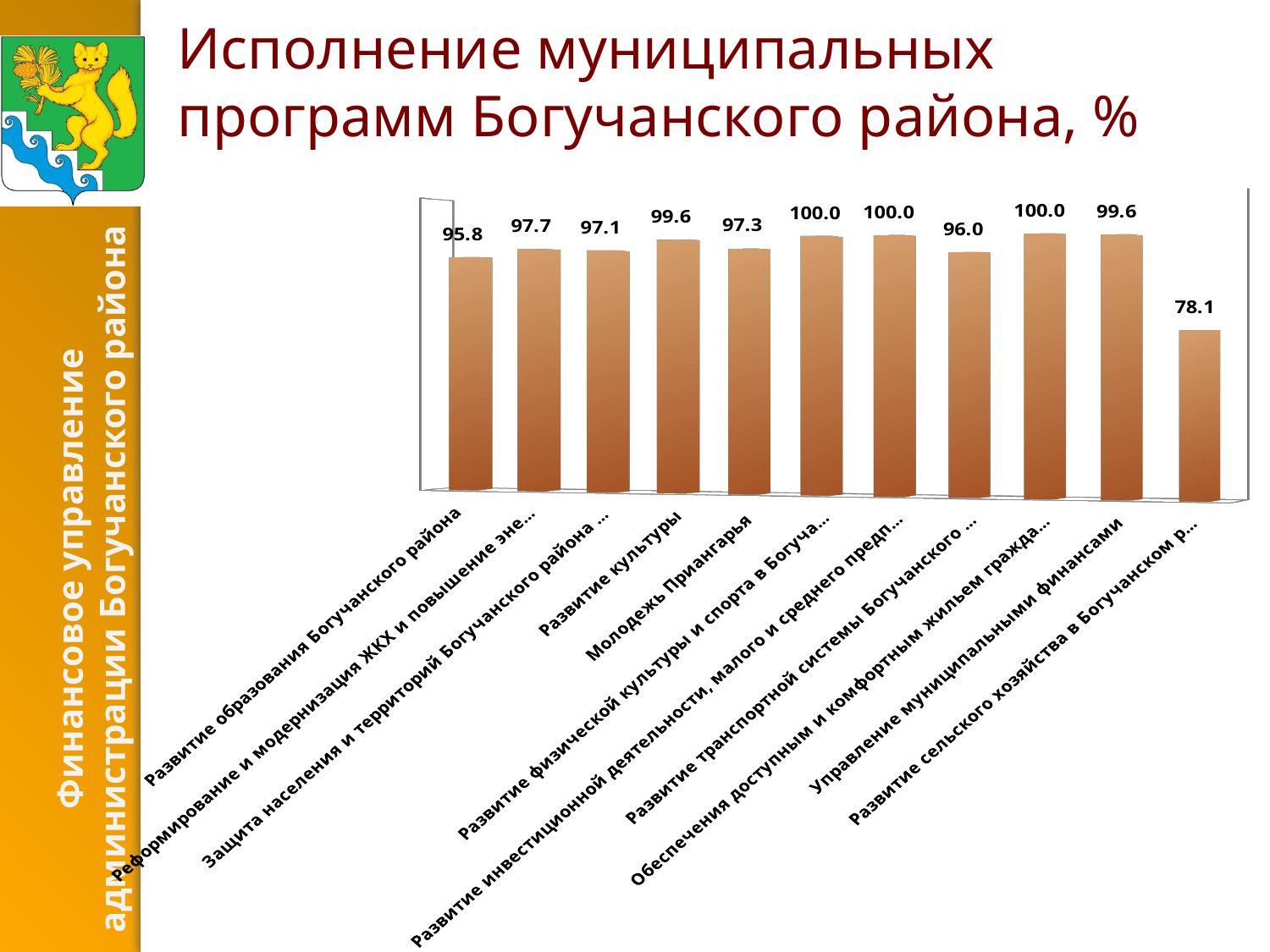
What is the value for Молодежь Приангарья? 97.3 What is the difference between the values for Развитие культуры and Молодежь Приангарья? 2.3 What is the value for Управление муниципальными финансами? 99.6 How many programs (bars) are shown on the chart? 11 What is the value for Развитие образования Богучанского района? 95.8 What is the value for Развитие культуры? 99.6 What is the lowest value shown on the chart? 78.1 What kind of chart is shown on the slide? Bar chart How many bars show a value of 100.0? 3 What is the title of the slide? Исполнение муниципальных программ Богучанского района, % Which program has the lowest value on the chart? Развитие сельского хозяйства в Богучанском р... Which is larger: the value for Развитие образования Богучанского района or the value for Молодежь Приангарья? Молодежь Приангарья